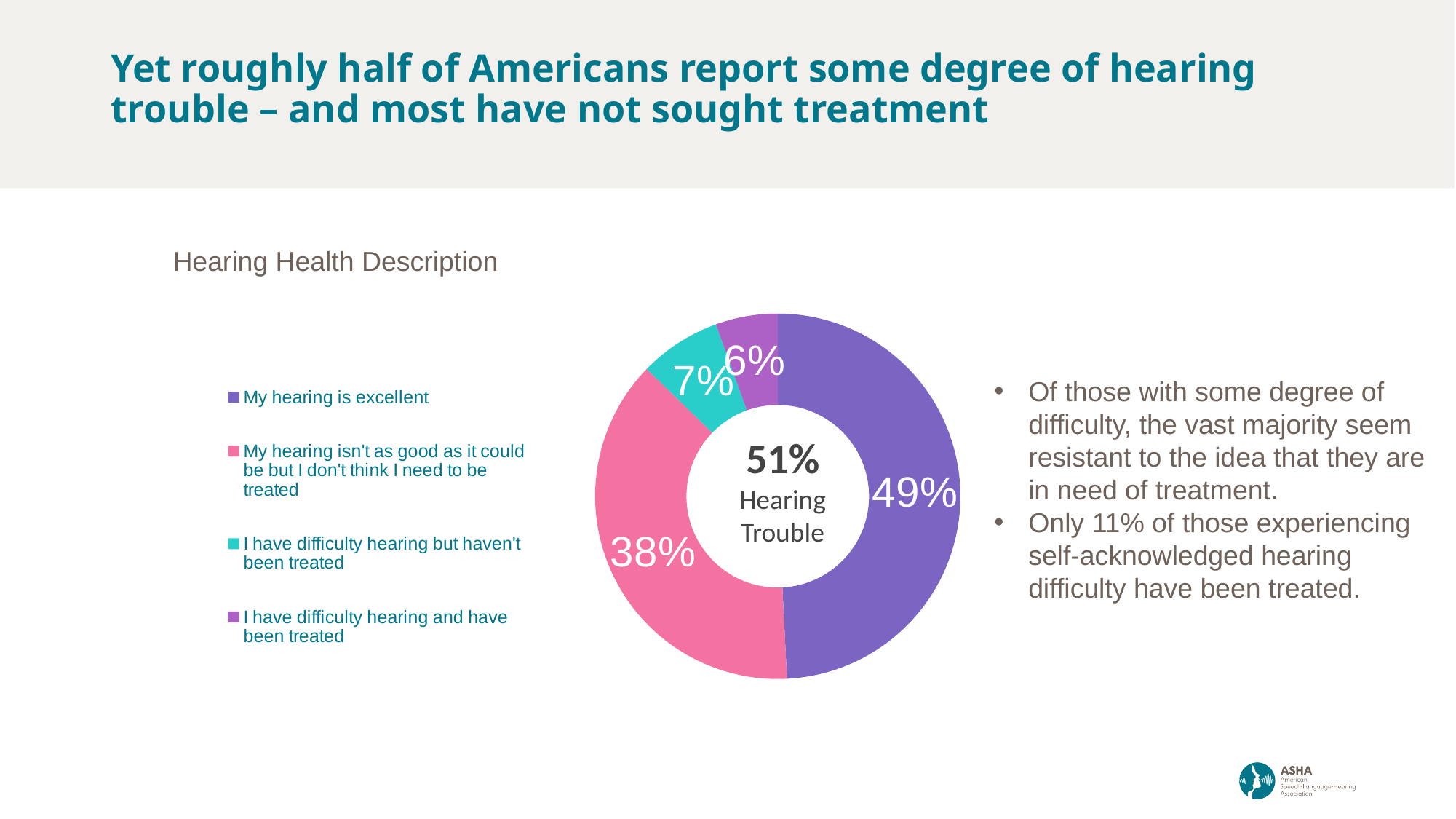
Which is larger: the share for 'I have difficulty hearing but haven't been treated' or the share for 'I have difficulty hearing and have been treated'? I have difficulty hearing but haven't been treated What percentage of respondents have difficulty hearing and have been treated? 6% How many categories does the pie chart show? 4 What is the title of the chart? Hearing Health Description What percentage of respondents say their hearing is excellent? 49% What percentage of respondents say their hearing isn't as good as it could be but they don't think they need to be treated? 38% Which category has the smallest share of the pie? I have difficulty hearing and have been treated What is the difference between the share for 'My hearing is excellent' and the share for 'My hearing isn't as good as it could be but I don't think I need to be treated'? 11% What percentage is printed in the centre of the doughnut chart? 51% Which category has the largest share of the pie? My hearing is excellent What percentage of respondents have difficulty hearing but haven't been treated? 7% What kind of chart is shown on the slide? Pie chart (doughnut)